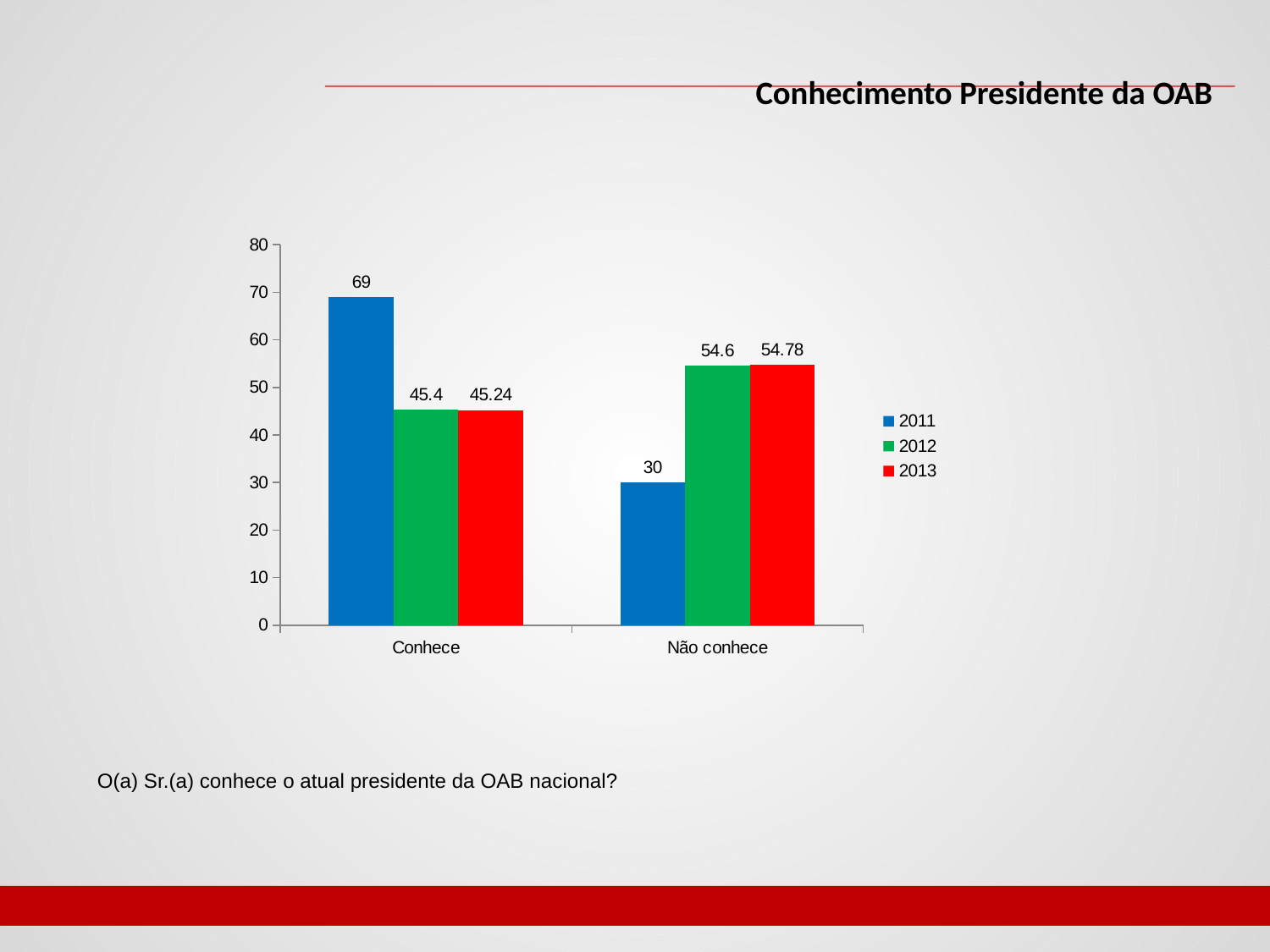
What is the value for 2011 in the Conhece category? 69 How many categories are shown on the x axis? 2 What kind of chart is shown on the slide? Bar chart What is the value for 2011 in the Não conhece category? 30 What is the value for 2012 in the Conhece category? 45.4 Which series has the highest value in the Conhece category? 2011 Which is larger: the 2012 value for Conhece or the 2012 value for Não conhece? Não conhece What is the title of the chart? Conhecimento Presidente da OAB What is the value for 2013 in the Não conhece category? 54.78 How many series does the legend list? 3 What is the difference between the 2011 values for Conhece and Não conhece? 39 Which series has the lowest value in the Não conhece category? 2011